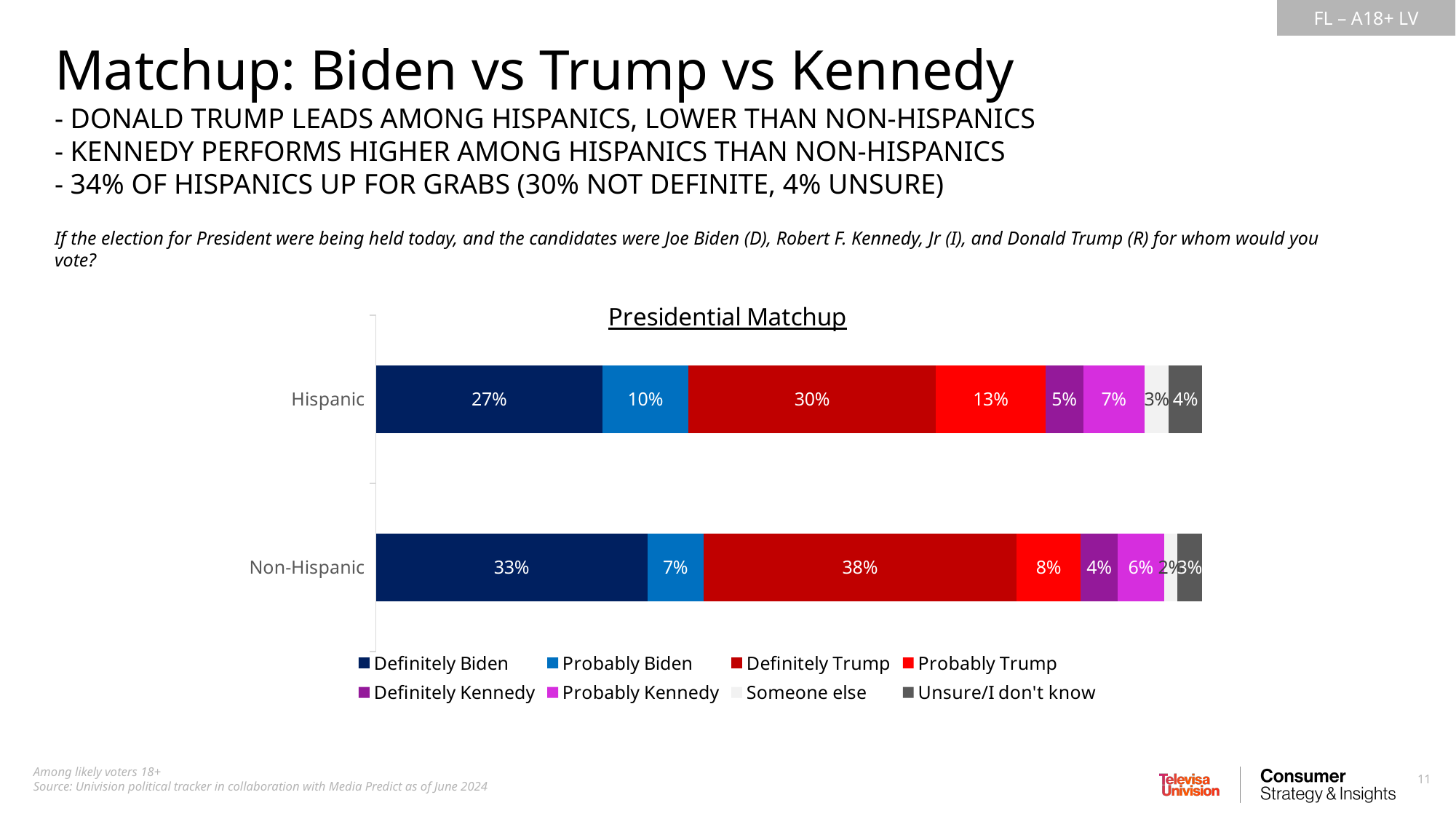
What is the difference between the Definitely Trump values for Non-Hispanic and Hispanic voters? 8% What kind of chart is the Presidential Matchup chart? Stacked bar chart How many series does the legend of the Presidential Matchup chart list? 8 What is the Probably Trump value for Non-Hispanic voters? 8% Which segment is the smallest in the Non-Hispanic bar? Someone else What is the Definitely Biden value for Non-Hispanic voters? 33% What colour represents Definitely Kennedy in the legend? Purple How many categories are shown on the Presidential Matchup chart? 2 What is the Probably Kennedy value for Hispanic voters? 7% Which is larger: Probably Biden for Hispanic voters or Probably Biden for Non-Hispanic voters? Hispanic Which segment is the largest in the Hispanic bar? Definitely Trump What is the Definitely Trump value for Hispanic voters? 30%